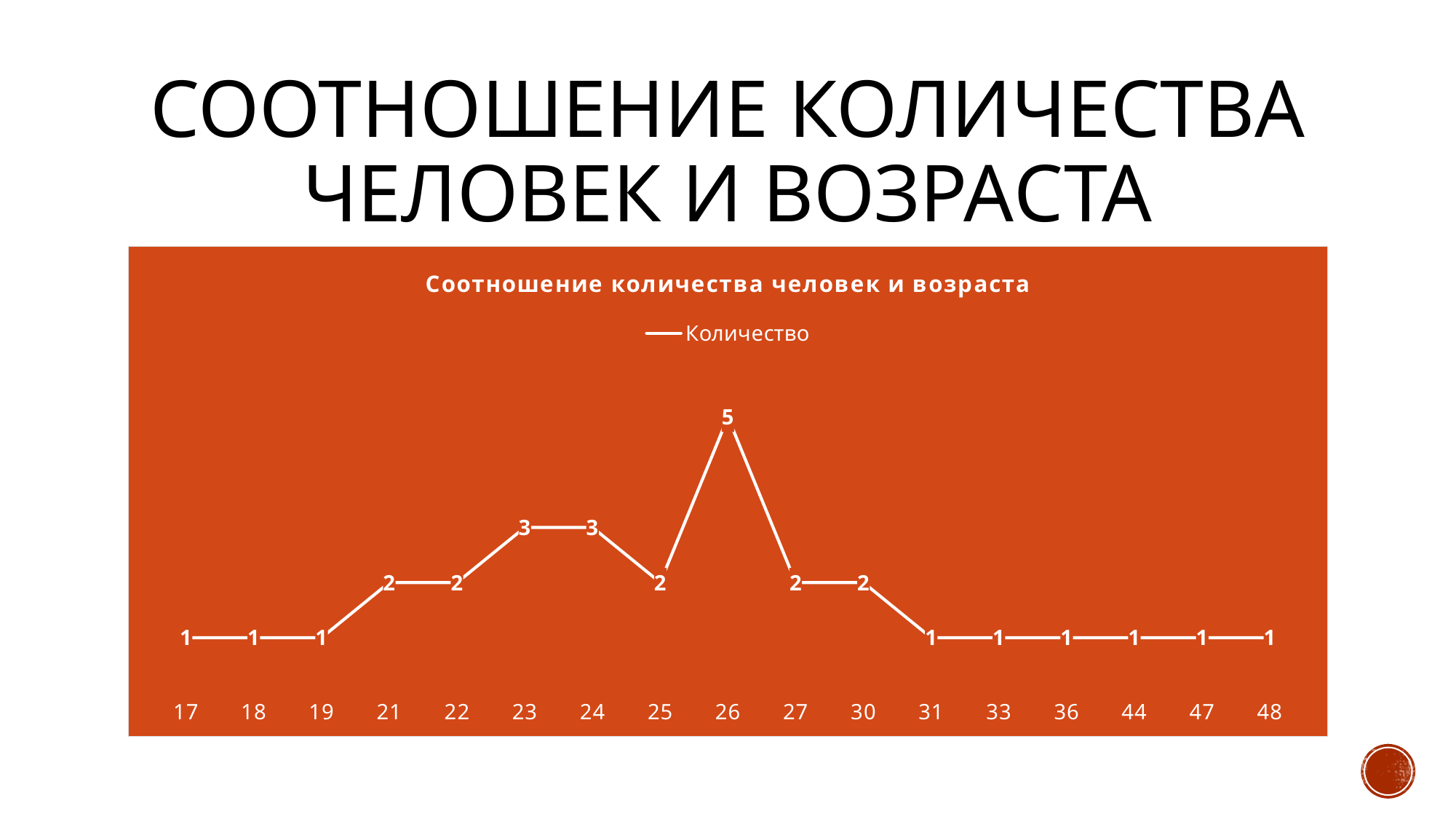
What is the difference between the values for age 26 and age 25? 3 What type of chart is shown on the slide? line chart Which age has the highest value? 26 What is the value for age 21? 2 How many series does the legend list? 1 What is the value for age 23? 3 What is the difference between the values for age 24 and age 31? 2 Which is larger, the value for age 22 or the value for age 23? 23 What is the value for age 26? 5 What is the name of the series in the legend? Количество How many age categories are shown on the x axis? 17 What is the value for age 48? 1